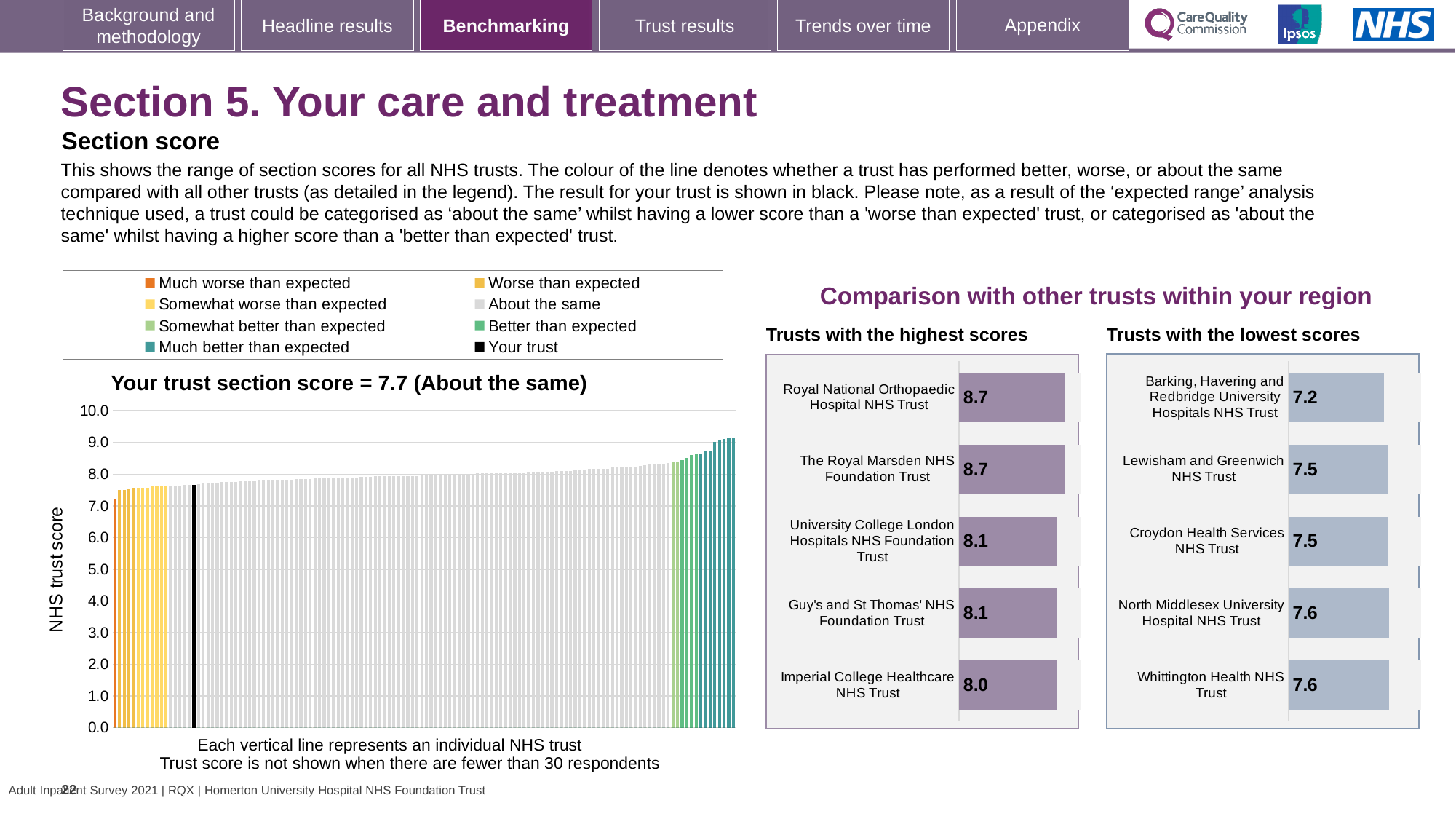
In the 'Your trust section score' chart, do the trust scores rise or fall from left to right along the x axis? rise In the 'Your trust section score' chart, what is the section score for your trust? 7.7 In the 'Trusts with the highest scores' chart, which trust has the lowest score? Imperial College Healthcare NHS Trust In the 'Trusts with the highest scores' chart, what is the difference between the score for Royal National Orthopaedic Hospital NHS Trust and the score for Imperial College Healthcare NHS Trust? 0.7 In the 'Trusts with the lowest scores' chart, which trust has the lowest score? Barking, Havering and Redbridge University Hospitals NHS Trust In the 'Your trust section score' chart, how many entries does the legend list? 8 In the 'Trusts with the lowest scores' chart, what is the score for Croydon Health Services NHS Trust? 7.5 In the 'Trusts with the highest scores' chart, how many trusts are shown? 5 In the 'Trusts with the lowest scores' chart, which has the larger score: Whittington Health NHS Trust or Lewisham and Greenwich NHS Trust? Whittington Health NHS Trust In the 'Your trust section score' chart, what is the label on the vertical axis? NHS trust score In the 'Trusts with the highest scores' chart, what is the score for Imperial College Healthcare NHS Trust? 8.0 In the 'Your trust section score' chart, what kind of chart is used to show the trust scores? bar chart